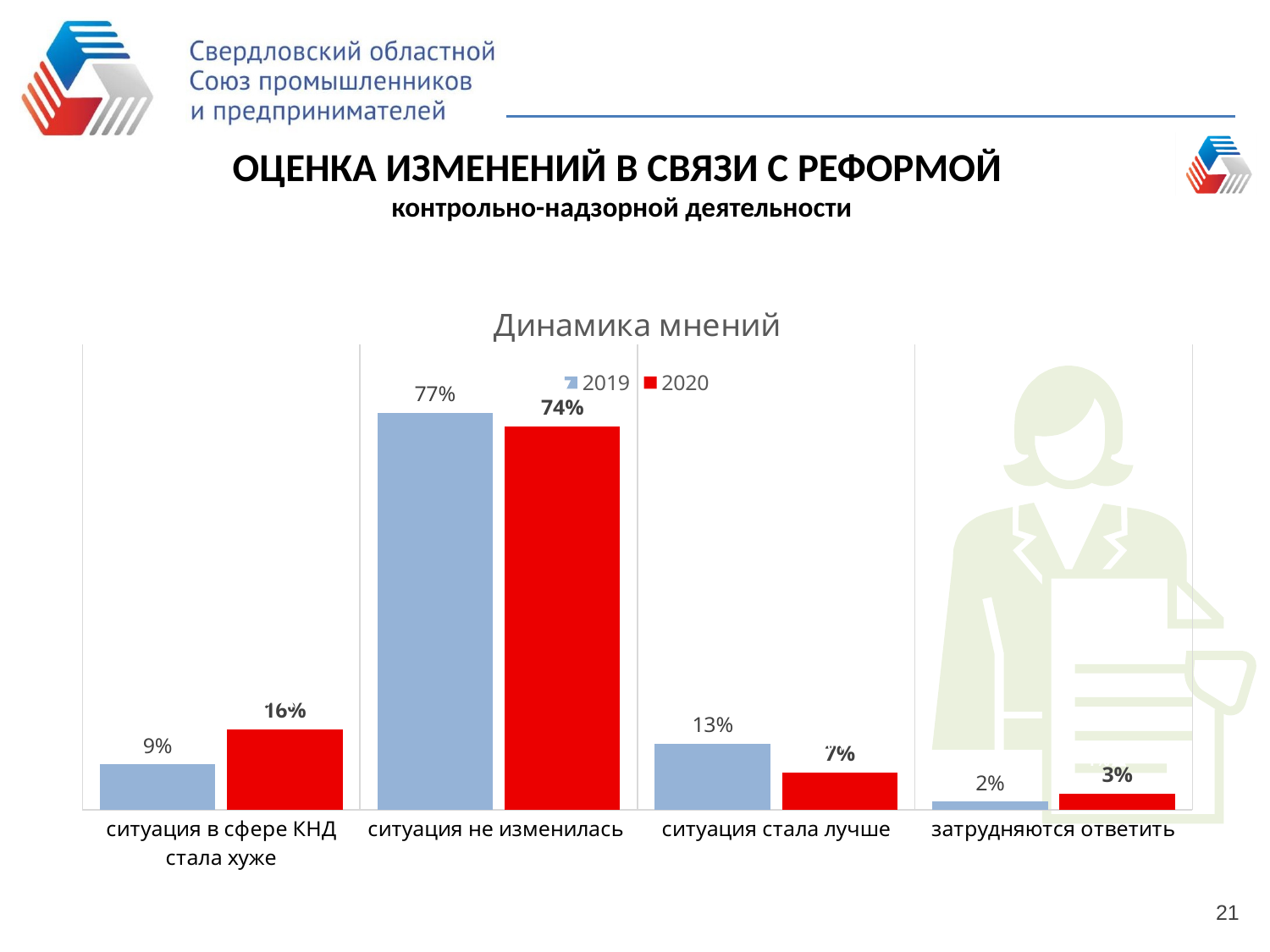
What is the title of the chart? Динамика мнений How many series does the legend list? 2 What is the 2020 value for "ситуация стала лучше"? 7% What is the difference between the 2019 and 2020 values for "ситуация не изменилась"? 3% What is the 2020 value for "ситуация в сфере КНД стала хуже"? 16% Which category has the highest 2020 value? ситуация не изменилась What is the difference between the 2019 and 2020 values for "ситуация стала лучше"? 6% What is the 2019 value for "затрудняются ответить"? 2% What is the 2019 value for "ситуация не изменилась"? 77% For "ситуация в сфере КНД стала хуже", which year has the larger value, 2019 or 2020? 2020 Which category has the lowest 2019 value? затрудняются ответить How many categories are shown on the x axis? 4